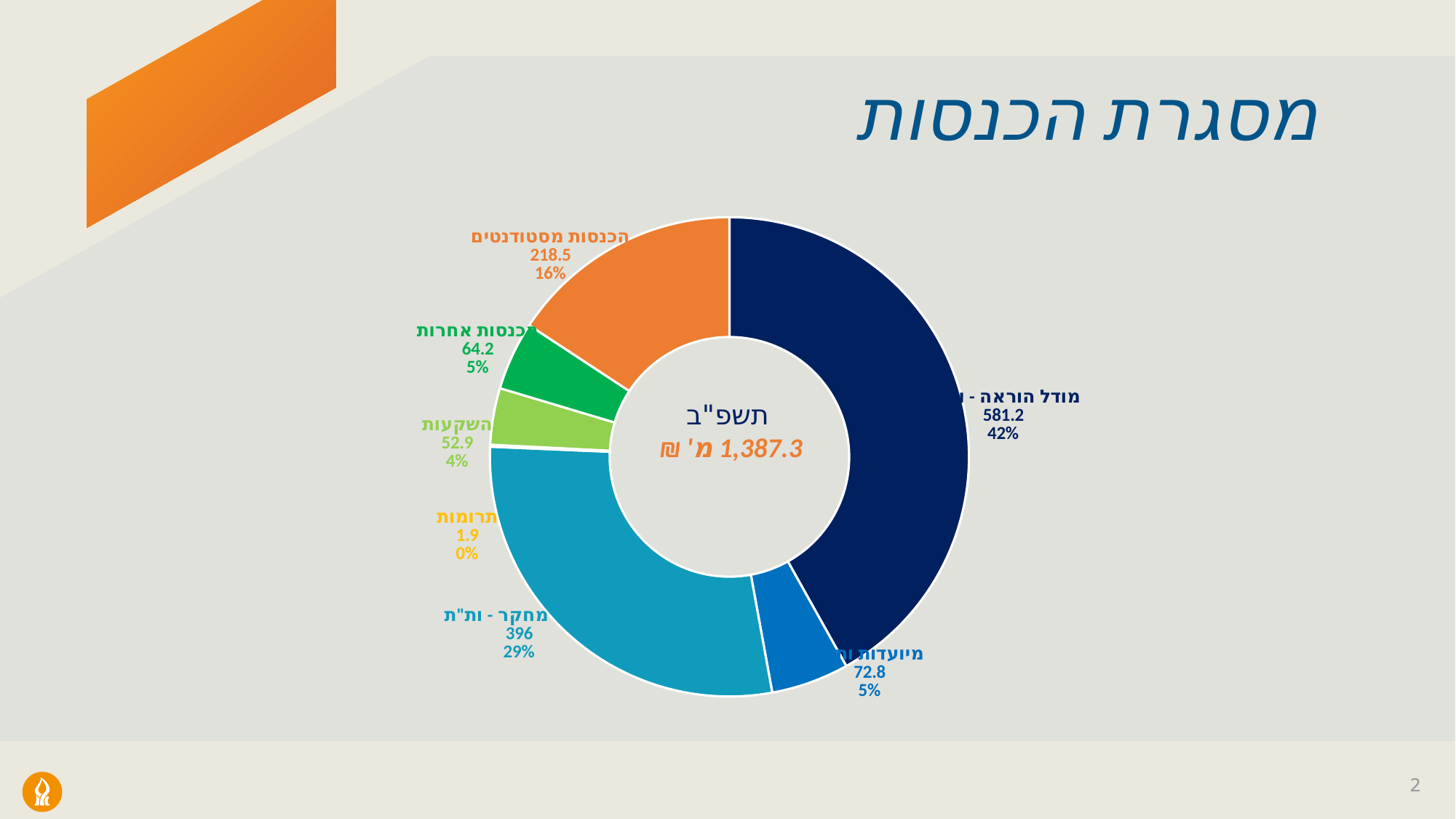
What is the value shown for הכנסות אחרות? 64.2 What percentage share does מודל הוראה have in the chart? 42% What percentage share does תרומות have in the chart? 0% What type of chart is shown on the slide? Pie (donut) chart What is the value shown for מחקר - ות"ת? 396 Which category has the smallest slice in the chart? תרומות Which category has the largest slice in the chart? מודל הוראה What total amount is shown in the centre of the donut chart? 1,387.3 מ' ₪ What is the difference between the values for מודל הוראה (581.2) and מחקר - ות"ת (396)? 185.2 What is the value shown for השקעות? 52.9 Which is larger, the value for הכנסות אחרות or the value for השקעות? הכנסות אחרות What is the value shown for הכנסות מסטודנטים? 218.5